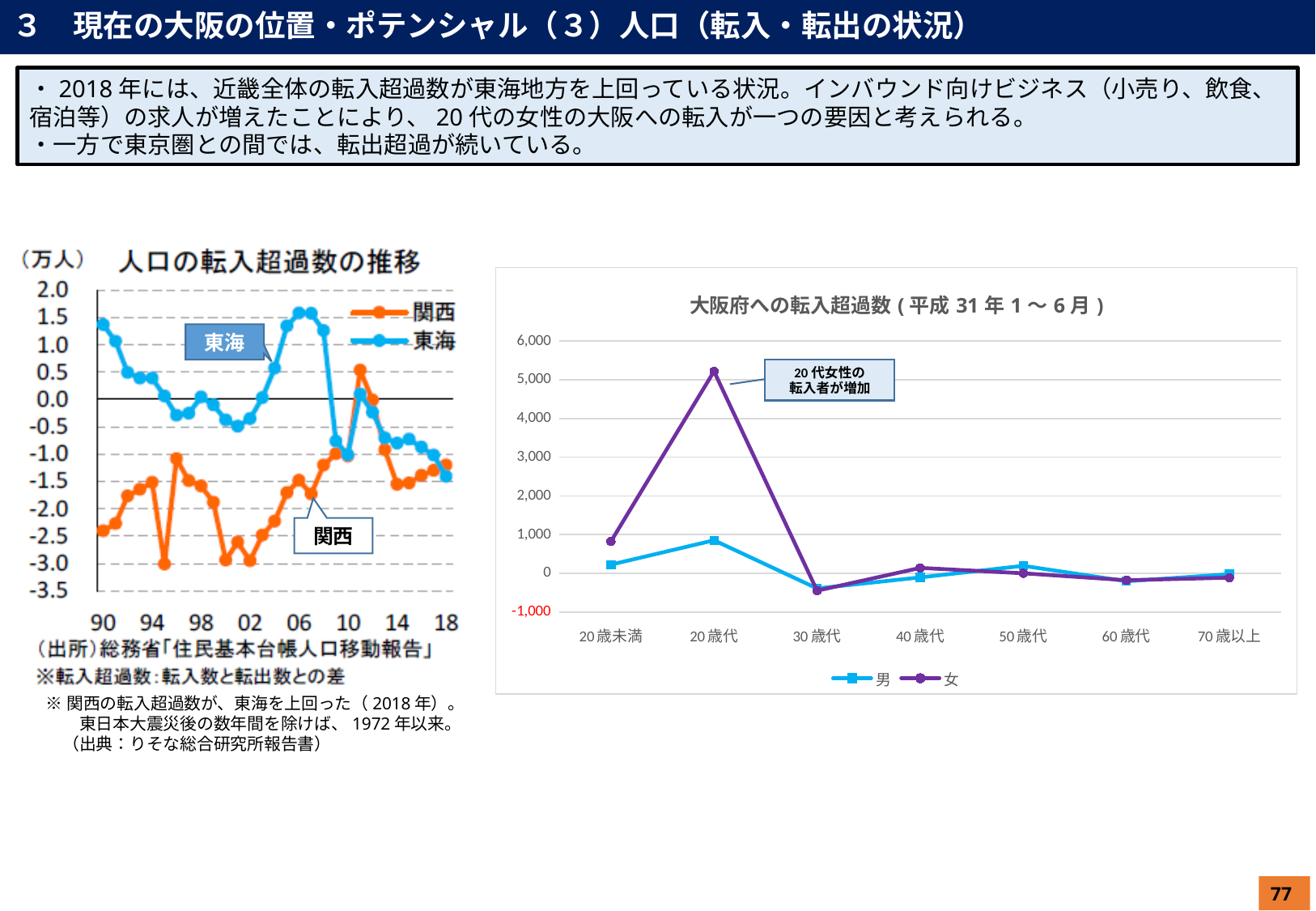
In the chart titled 大阪府への転入超過数 (平成31年1～6月), which age group has the highest value for 女? 20歳代 In the chart titled 人口の転入超過数の推移, what unit is shown for the y axis? 万人 In the chart titled 人口の転入超過数の推移, how many series does the legend list? 2 In the chart titled 大阪府への転入超過数 (平成31年1～6月), is the value for 男 at 20歳代 greater or less than 1,000? less What kind of chart is the chart titled 大阪府への転入超過数 (平成31年1～6月)? line chart In the chart titled 大阪府への転入超過数 (平成31年1～6月), how many series does the legend list? 2 In the chart titled 大阪府への転入超過数 (平成31年1～6月), how many age groups are shown on the x axis? 7 In the chart titled 大阪府への転入超過数 (平成31年1～6月), is the value for 女 at 20歳代 greater or less than 4,000? greater In the chart titled 大阪府への転入超過数 (平成31年1～6月), which is larger at 20歳代, 男 or 女? 女 In the chart titled 大阪府への転入超過数 (平成31年1～6月), does the 女 line rise or fall from 20歳代 to 30歳代? fall In the chart titled 人口の転入超過数の推移, which series reaches the highest value around 2006? 東海 In the chart titled 大阪府への転入超過数 (平成31年1～6月), is the value for 女 at 30歳代 greater or less than 0? less